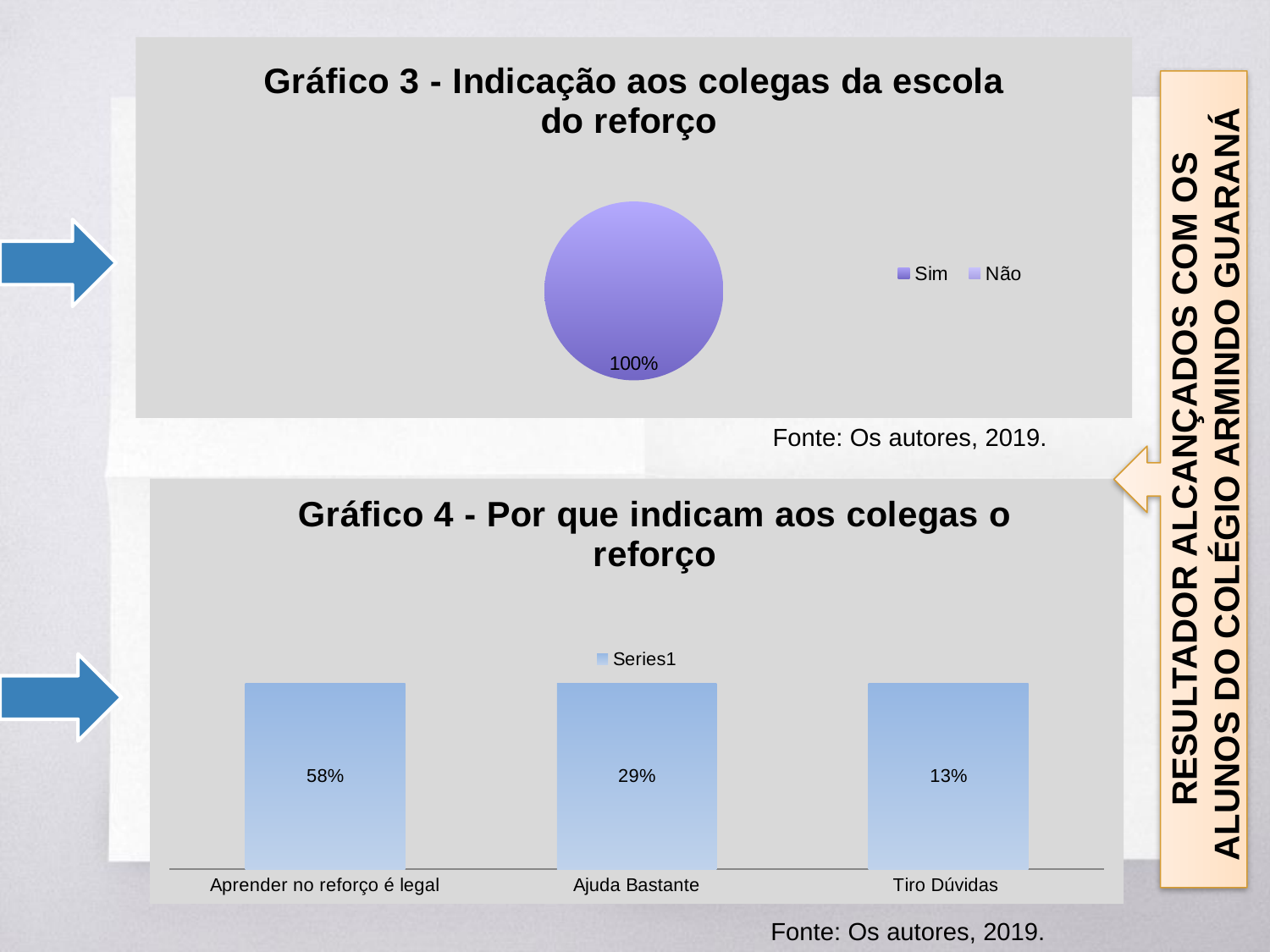
In Gráfico 3 - Indicação aos colegas da escola do reforço, what kind of chart is shown? pie chart In Gráfico 4 - Por que indicam aos colegas o reforço, how many categories are shown on the x axis? 3 In Gráfico 3 - Indicação aos colegas da escola do reforço, what share of the pie does the Sim slice take? 100% In Gráfico 4 - Por que indicam aos colegas o reforço, which category has the highest labelled value? Aprender no reforço é legal In Gráfico 4 - Por que indicam aos colegas o reforço, what is the difference between the values for Aprender no reforço é legal and Ajuda Bastante? 29% In Gráfico 4 - Por que indicam aos colegas o reforço, which category has the lowest labelled value? Tiro Dúvidas In Gráfico 4 - Por que indicam aos colegas o reforço, what is the value for Aprender no reforço é legal? 58% In Gráfico 3 - Indicação aos colegas da escola do reforço, how many entries does the legend list? 2 In Gráfico 4 - Por que indicam aos colegas o reforço, what kind of chart is shown? bar chart In Gráfico 4 - Por que indicam aos colegas o reforço, what is the value for Tiro Dúvidas? 13% In Gráfico 3 - Indicação aos colegas da escola do reforço, what are the two legend entries? Sim and Não In Gráfico 4 - Por que indicam aos colegas o reforço, what is the value for Ajuda Bastante? 29%